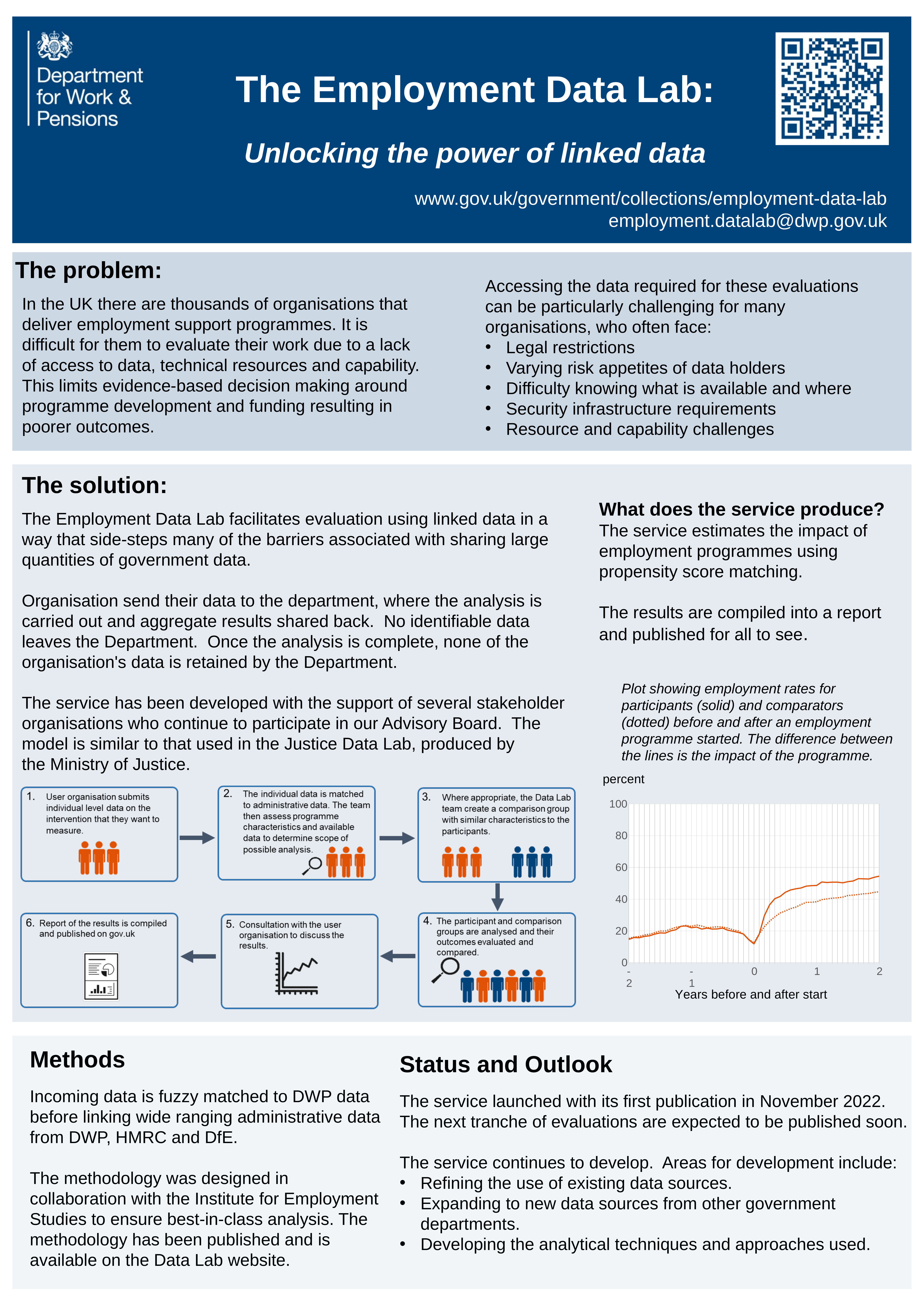
How many lines are plotted on the chart? 2 Is the employment rate at the programme start (year 0) greater or less than 20? less At 2 years after start, which line is higher: participants (solid) or comparators (dotted)? participants (solid) What kind of chart is shown on the slide? line chart Is the participants (solid) employment rate at 2 years before start greater or less than 40? less Is the participants (solid) employment rate at 2 years after start greater or less than 40? greater What is the highest value shown on the y axis of the chart? 100 What is the label of the y axis of the chart? percent Do the employment rates rise or fall between year -1 and year 0? fall What is the label of the x axis of the chart? Years before and after start Do the employment rates rise or fall between year 0 and year 2 after start? rise